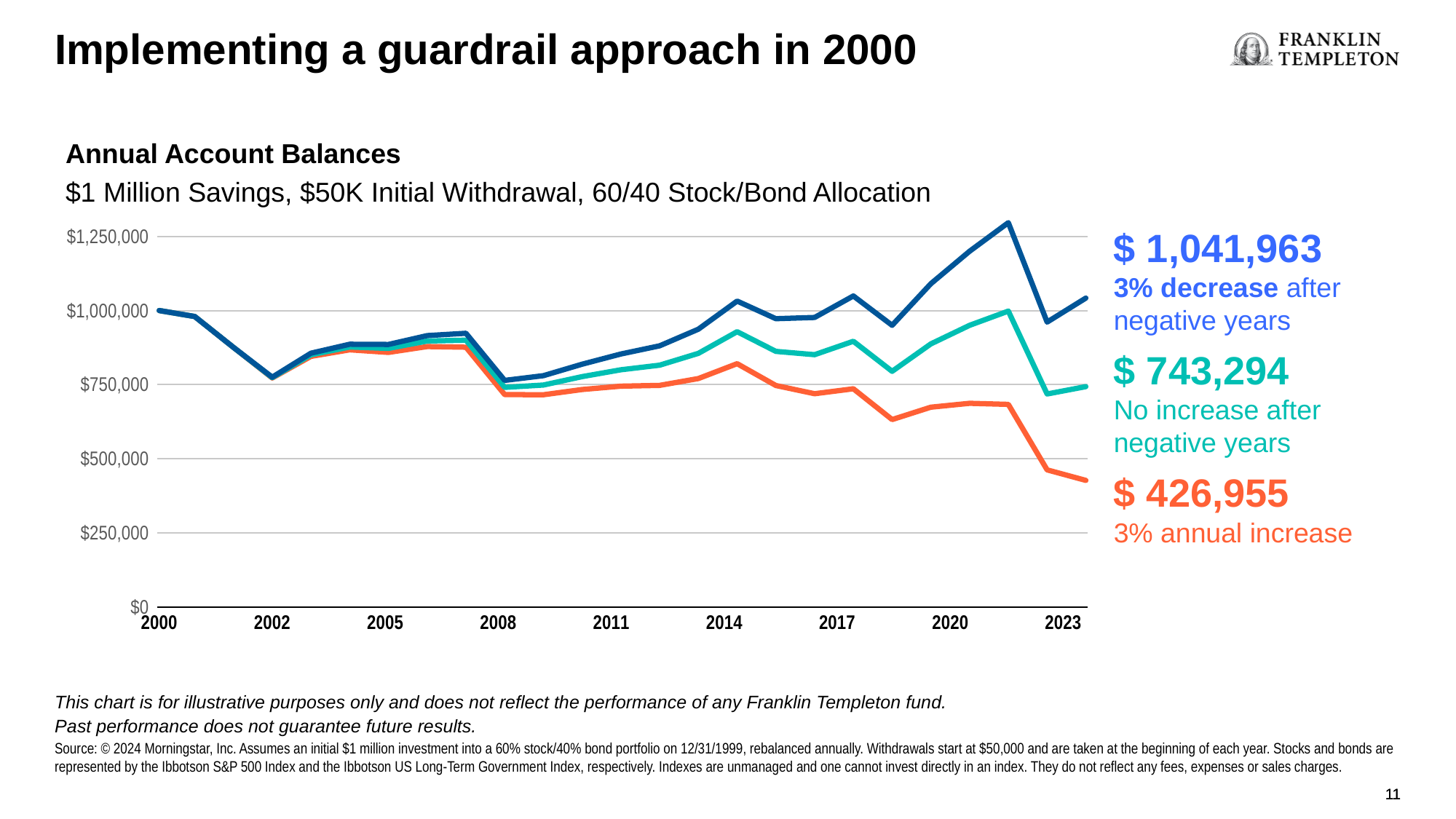
How many series (withdrawal strategies) are plotted on the chart? 3 Which strategy ends with the highest account balance? 3% decrease after negative years What kind of chart is shown on the slide? Line chart What is the difference between the ending balances of the '3% decrease after negative years' and 'No increase after negative years' strategies? $298,669 What is the ending account balance for the '3% annual increase' strategy? $ 426,955 Is the ending value for the '3% annual increase' strategy greater or less than $500,000? less What is the title of the chart? Annual Account Balances Which strategy ends with the lowest account balance? 3% annual increase What is the difference between the ending balances of the 'No increase after negative years' and '3% annual increase' strategies? $316,339 Is the peak value of the '3% decrease after negative years' line greater or less than $1,250,000? greater What is the ending account balance for the 'No increase after negative years' strategy? $ 743,294 What is the ending account balance for the '3% decrease after negative years' strategy? $ 1,041,963